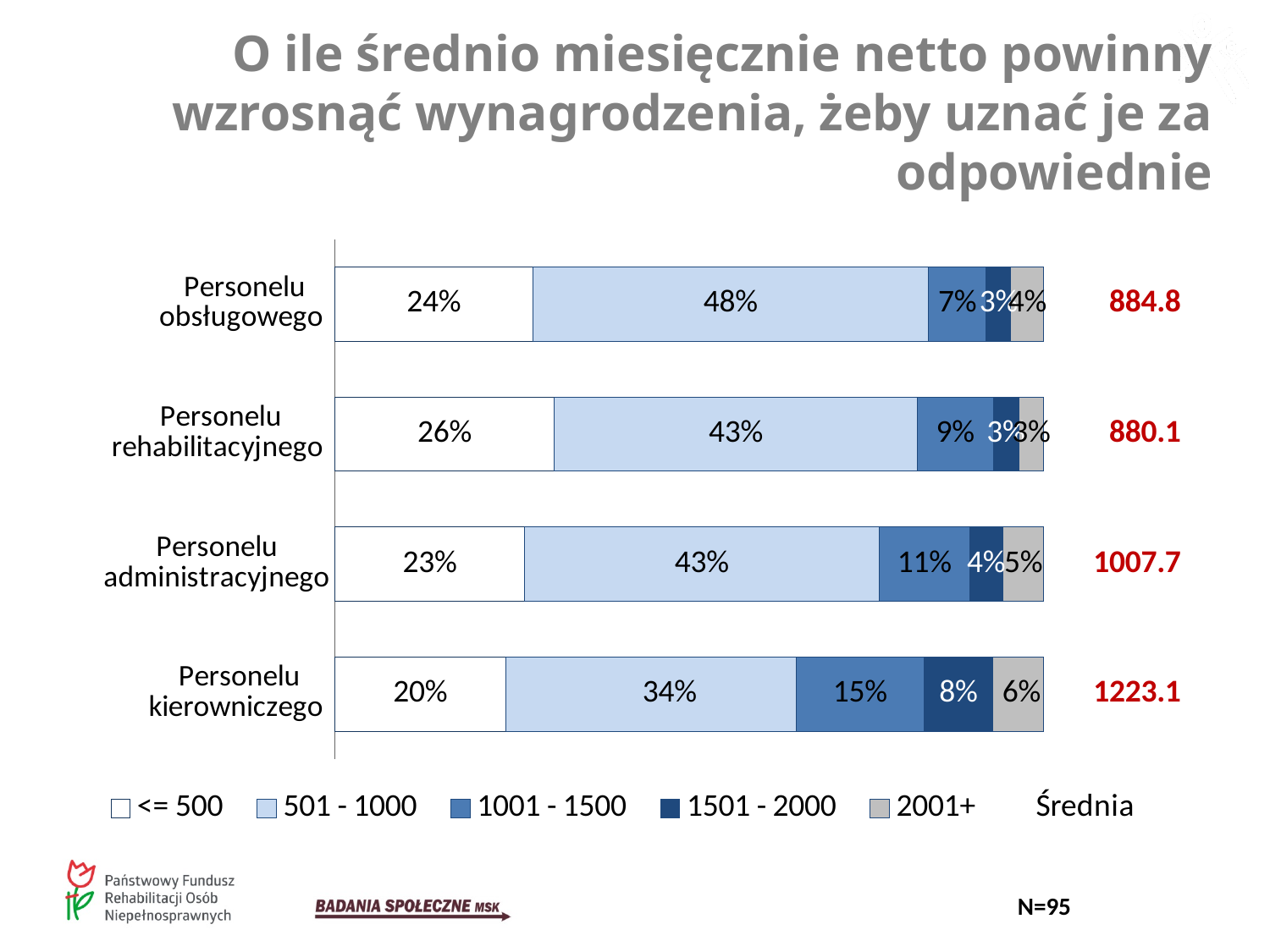
How many staff categories are shown on the chart? 4 How many series does the legend list for the stacked bars? 5 Which staff category has the lowest Średnia value? Personelu rehabilitacyjnego What is the value of the '2001+' segment for Personelu administracyjnego? 5% What kind of chart is shown on the slide? Stacked bar chart Which staff category has the highest Średnia value? Personelu kierowniczego What is the value of the '<= 500' segment for Personelu obsługowego? 24% Which staff category has the largest '501 - 1000' segment? Personelu obsługowego What is the difference between the '<= 500' values for Personelu rehabilitacyjnego and Personelu kierowniczego? 6% What is the value of the '501 - 1000' segment for Personelu rehabilitacyjnego? 43% What is the value of the '1001 - 1500' segment for Personelu kierowniczego? 15% What is the Średnia value shown for Personelu kierowniczego? 1223.1